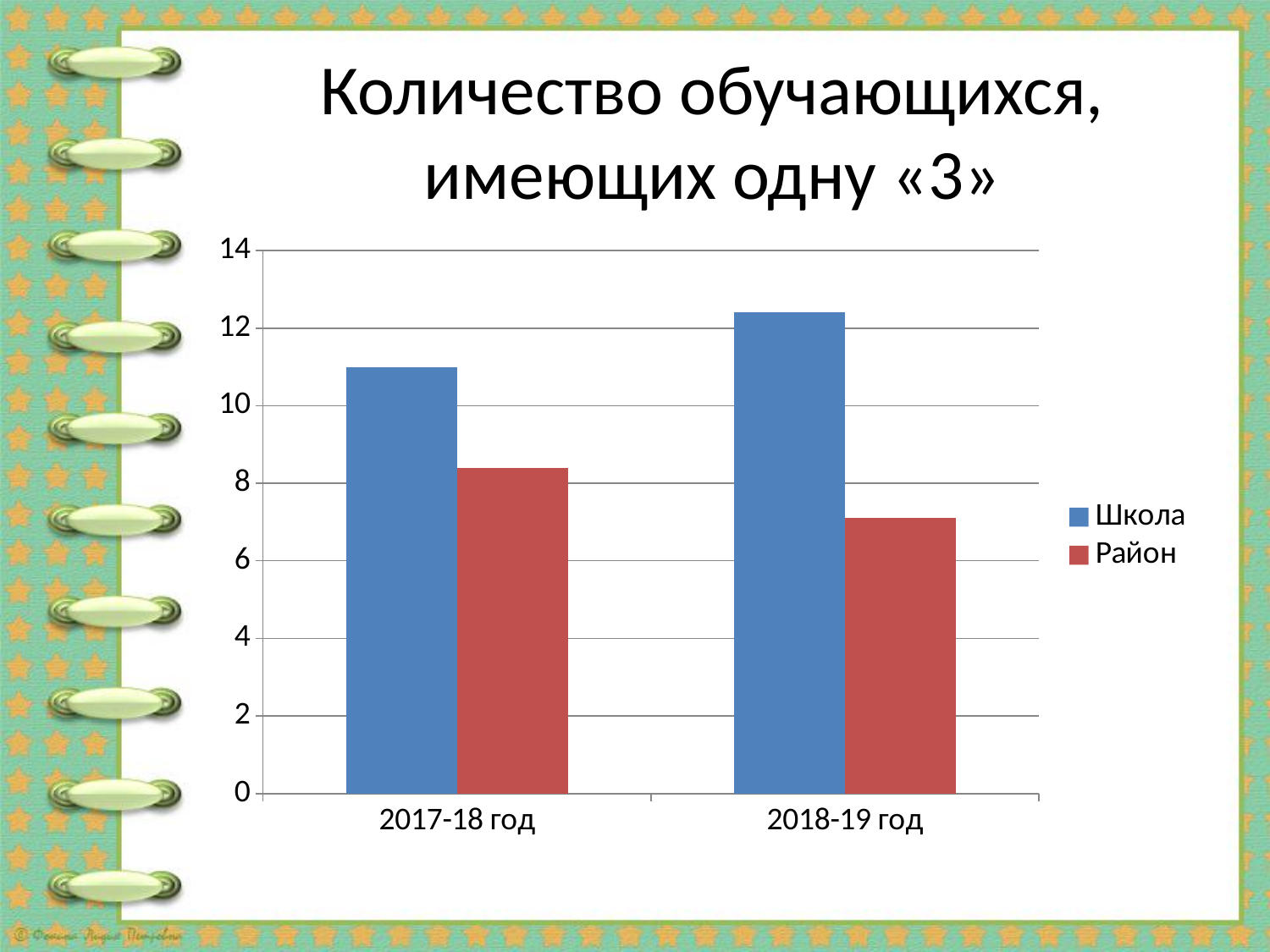
Which series is larger in 2017-18 год, Школа or Район? Школа Is the value for Район in 2017-18 год greater or less than 8? greater Does the value for Район rise or fall from 2017-18 год to 2018-19 год? fall Does the value for Школа rise or fall from 2017-18 год to 2018-19 год? rise What colour are the bars for the Район series? red Which series is larger in 2018-19 год, Школа or Район? Школа How many series does the legend list? 2 Is the value for Район in 2018-19 год greater or less than 8? less How many categories are shown on the x axis? 2 Is the value for Школа in 2017-18 год greater or less than 10? greater What kind of chart is shown on the slide? bar chart